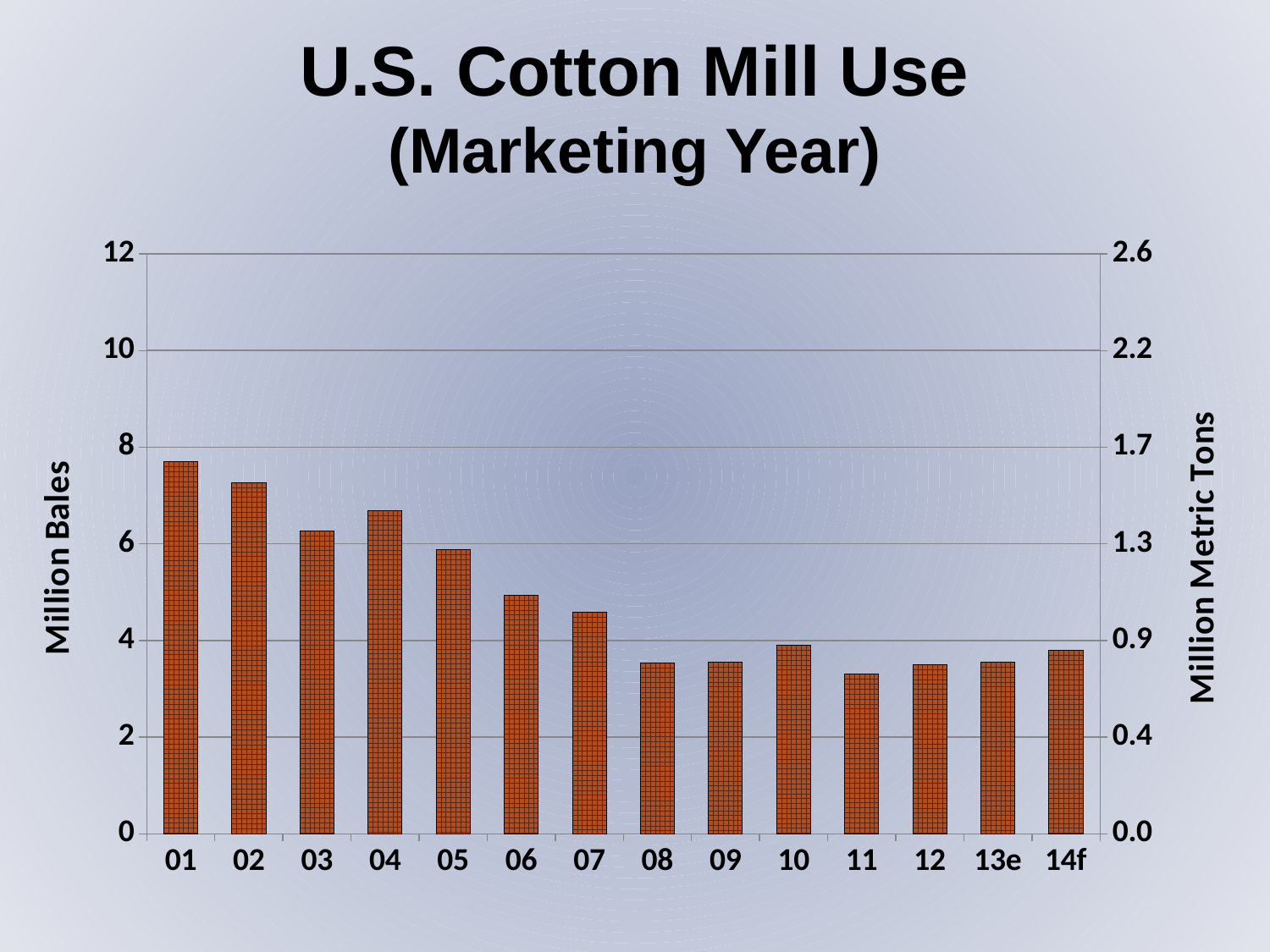
Do the values generally rise or fall from 01 to 14f? fall Is the value for 01 greater or less than 6 million bales? greater Is the value for 05 greater or less than 4 million bales? greater Which has the larger value, 03 or 04? 04 Is the value for 11 greater or less than 4 million bales? less Which has the larger value, 06 or 07? 06 Which marketing year has the lowest cotton mill use? 11 How many marketing years are plotted on the chart? 14 Which marketing year has the highest cotton mill use? 01 What is the label of the left vertical axis? Million Bales What kind of chart is shown on the slide? bar chart